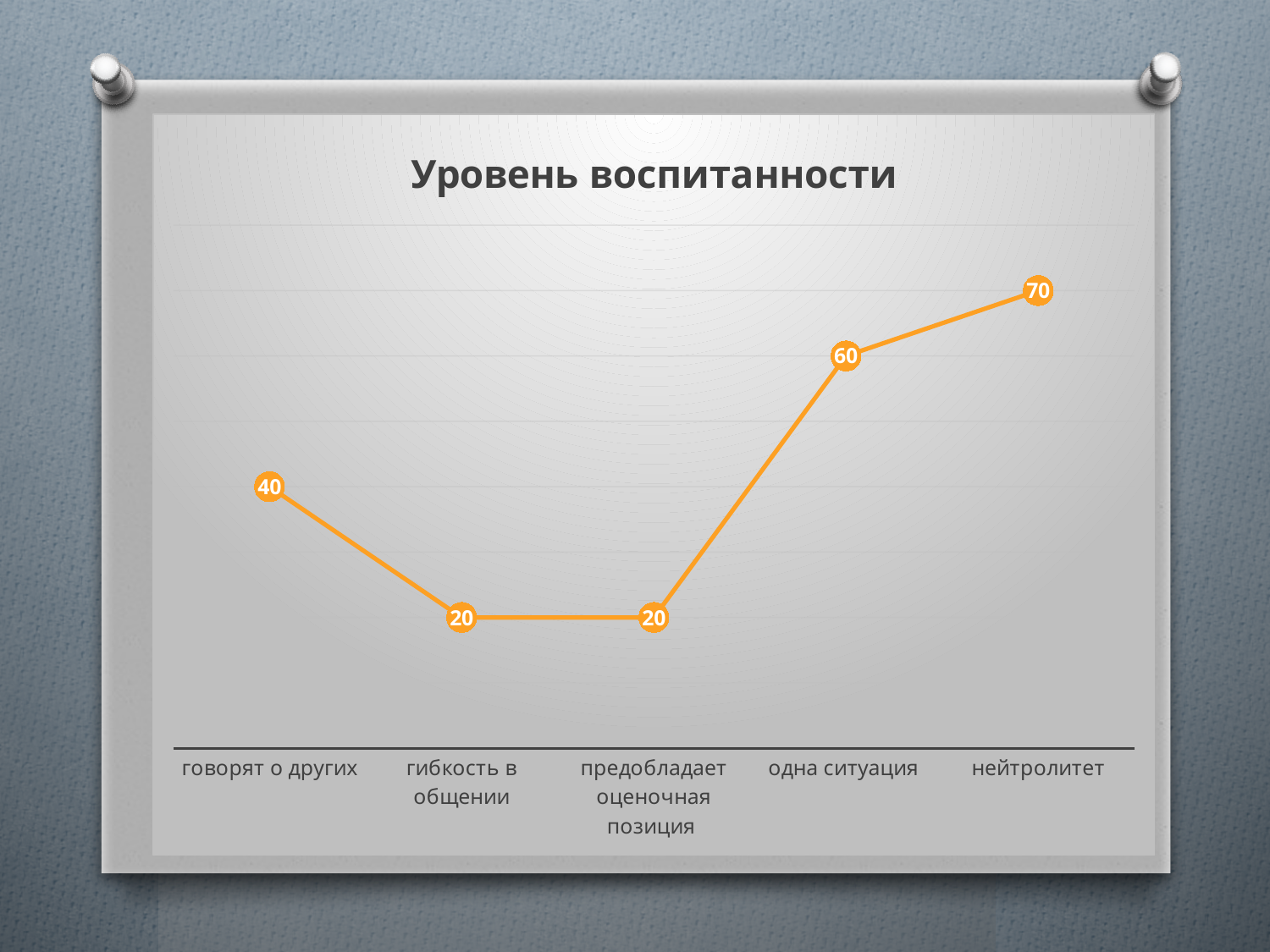
Which category has the highest value? нейтролитет What is the difference between the values for "нейтролитет" and "говорят о других"? 30 What kind of chart is shown on the slide? line chart What is the value for "говорят о других"? 40 What is the difference between the values for "одна ситуация" and "предобладает оценочная позиция"? 40 What is the value for "нейтролитет"? 70 Which is larger, the value for "говорят о других" or the value for "гибкость в общении"? говорят о других What is the value for "одна ситуация"? 60 What is the title of the chart? Уровень воспитанности Do the values rise or fall from "предобладает оценочная позиция" to "нейтролитет"? rise What is the value for "гибкость в общении"? 20 How many categories are plotted on the x axis? 5